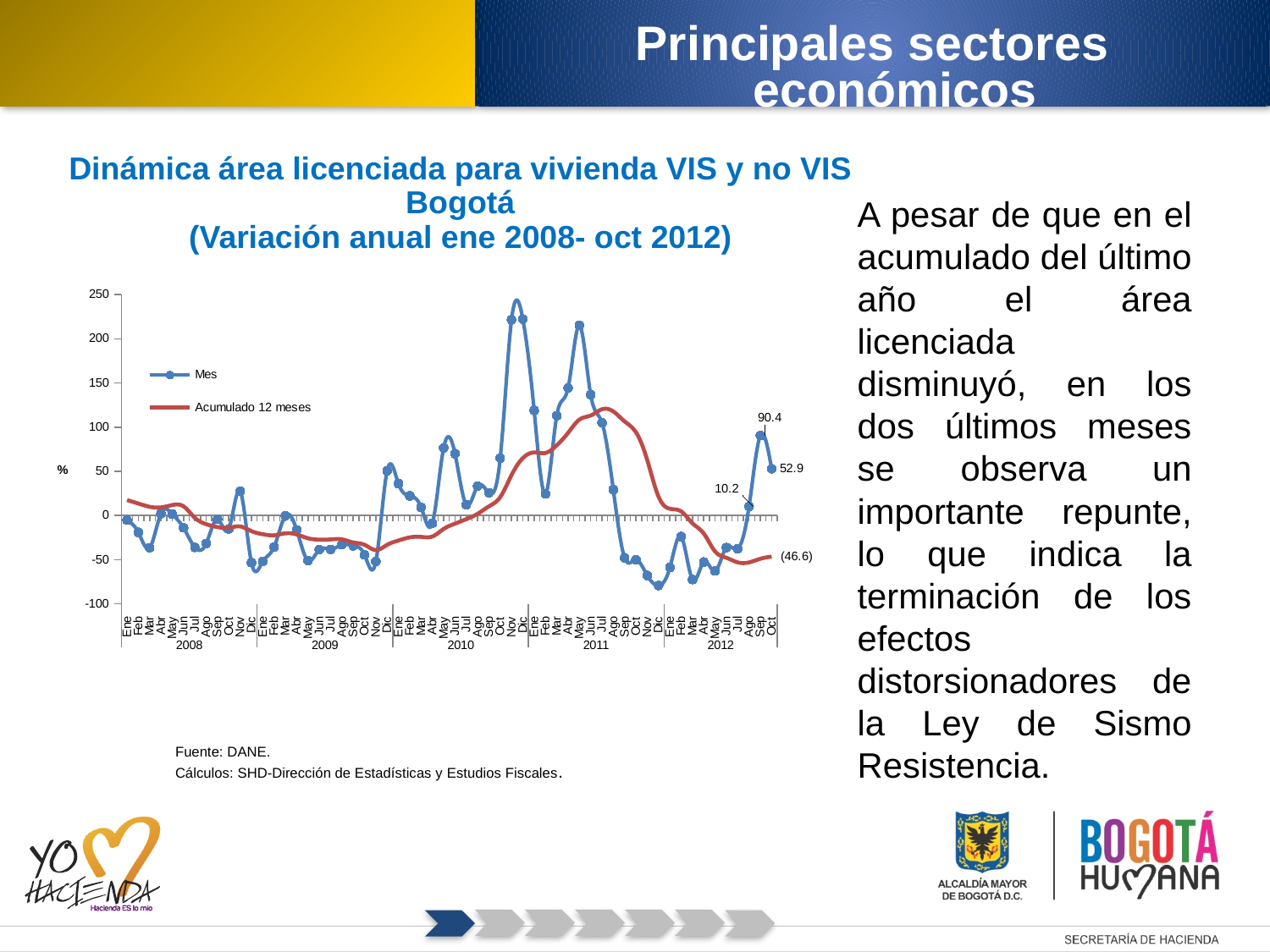
What is the value of the Mes series for Oct 2012? 52.9 What type of chart is shown on the slide? line chart What are the two series named in the chart legend? Mes and Acumulado 12 meses What is the value of the Mes series for Sep 2012? 90.4 What is the value of the Acumulado 12 meses series for Oct 2012? (46.6) Is the lowest value of the Mes series greater or less than -50? less Which is larger for the Mes series: Sep 2012 or Oct 2012? Sep 2012 What is the difference between the Mes values for Sep 2012 and Oct 2012? 37.5 What unit is shown on the vertical axis of the chart? % Is the highest value of the Mes series greater or less than 200? greater How many series does the chart legend list? 2 What is the value of the Mes series for Ago 2012? 10.2